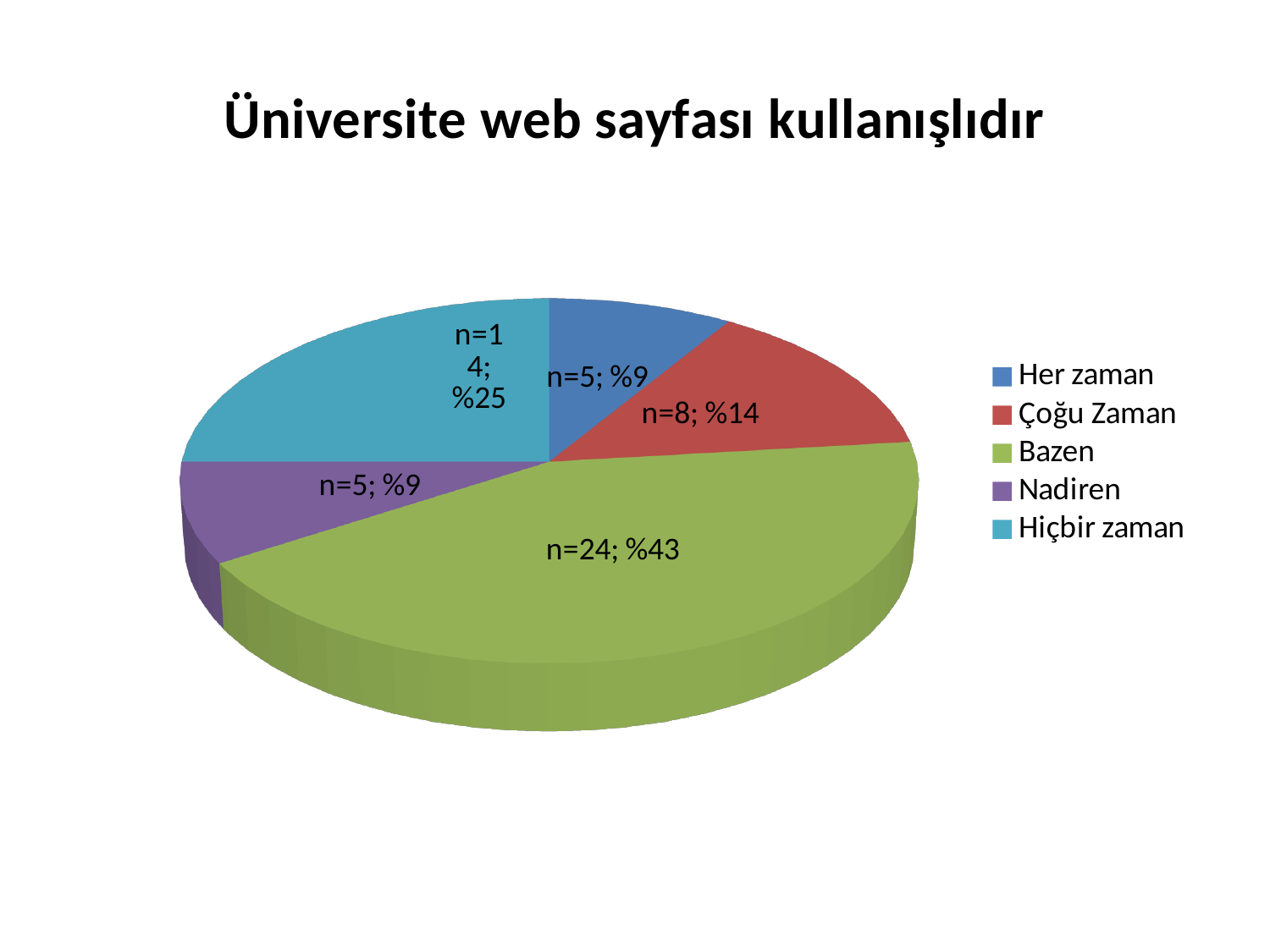
What is the count (n) for the Çoğu Zaman slice? n=8 How many categories does the legend list? 5 What percentage share does the Bazen slice have? %43 What percentage share does the Her zaman slice have? %9 What is the title of the chart? Üniversite web sayfası kullanışlıdır Which colour represents Nadiren in the chart? Purple Which is larger, the Hiçbir zaman slice or the Çoğu Zaman slice? Hiçbir zaman What kind of chart is shown on the slide? Pie chart What is the count (n) for the Bazen slice? n=24 What is the difference in count (n) between the Bazen slice and the Hiçbir zaman slice? 10 What percentage share does the Hiçbir zaman slice have? %25 Which category has the largest slice? Bazen